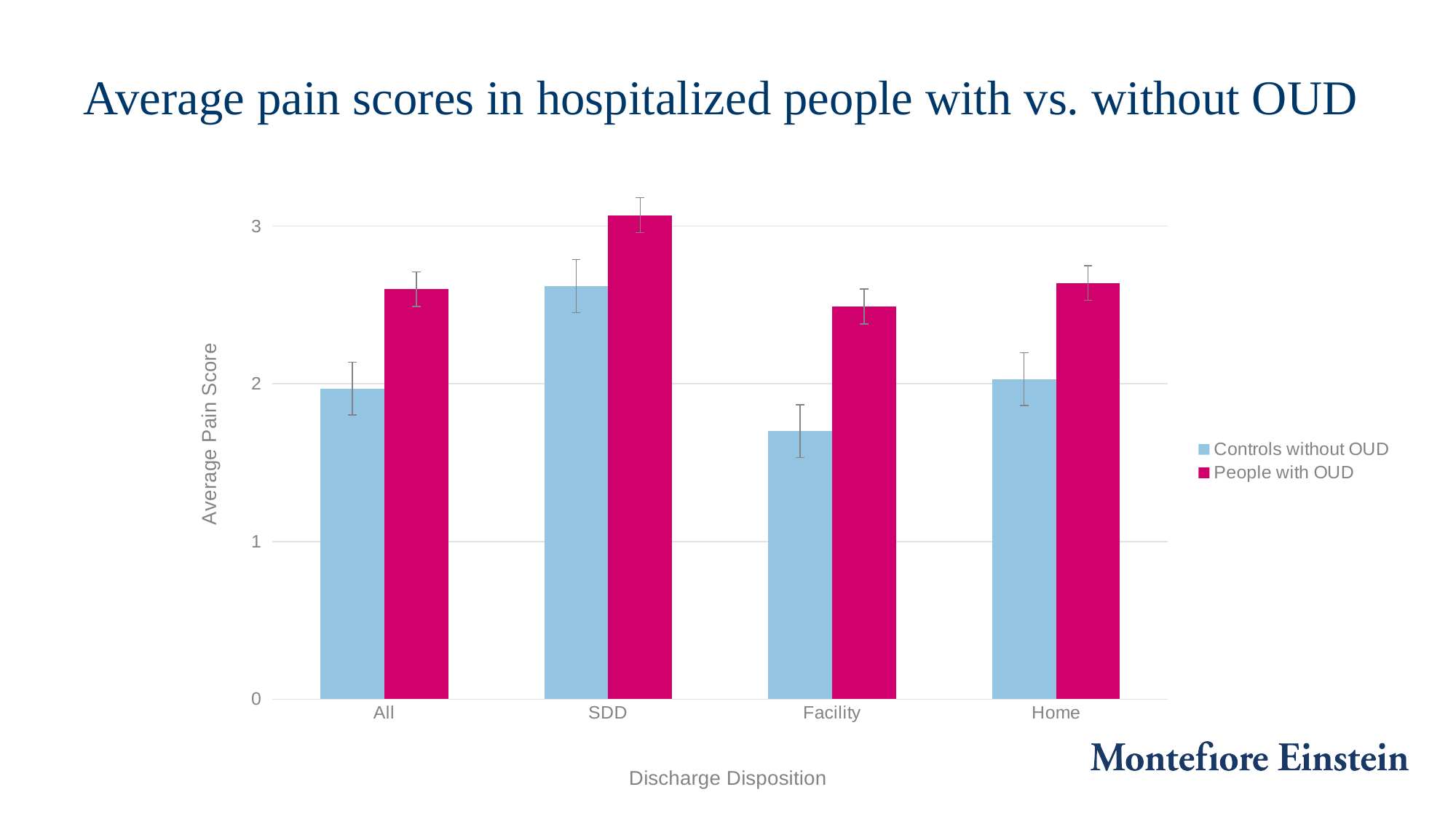
Is the average pain score for Controls without OUD in the SDD category greater or less than 2? greater Is the average pain score for People with OUD in the All category greater or less than 3? less What kind of chart is shown on the slide? bar chart For the All category, which group has the higher average pain score, Controls without OUD or People with OUD? People with OUD For the Facility category, which group has the higher average pain score, Controls without OUD or People with OUD? People with OUD For which discharge disposition is the average pain score for Controls without OUD highest? SDD For which discharge disposition is the average pain score for Controls without OUD lowest? Facility For which discharge disposition is the average pain score for People with OUD highest? SDD Is the average pain score for Controls without OUD in the Facility category greater or less than 2? less What is the label of the y axis? Average Pain Score How many discharge disposition categories are shown on the x axis? 4 How many series does the legend list? 2